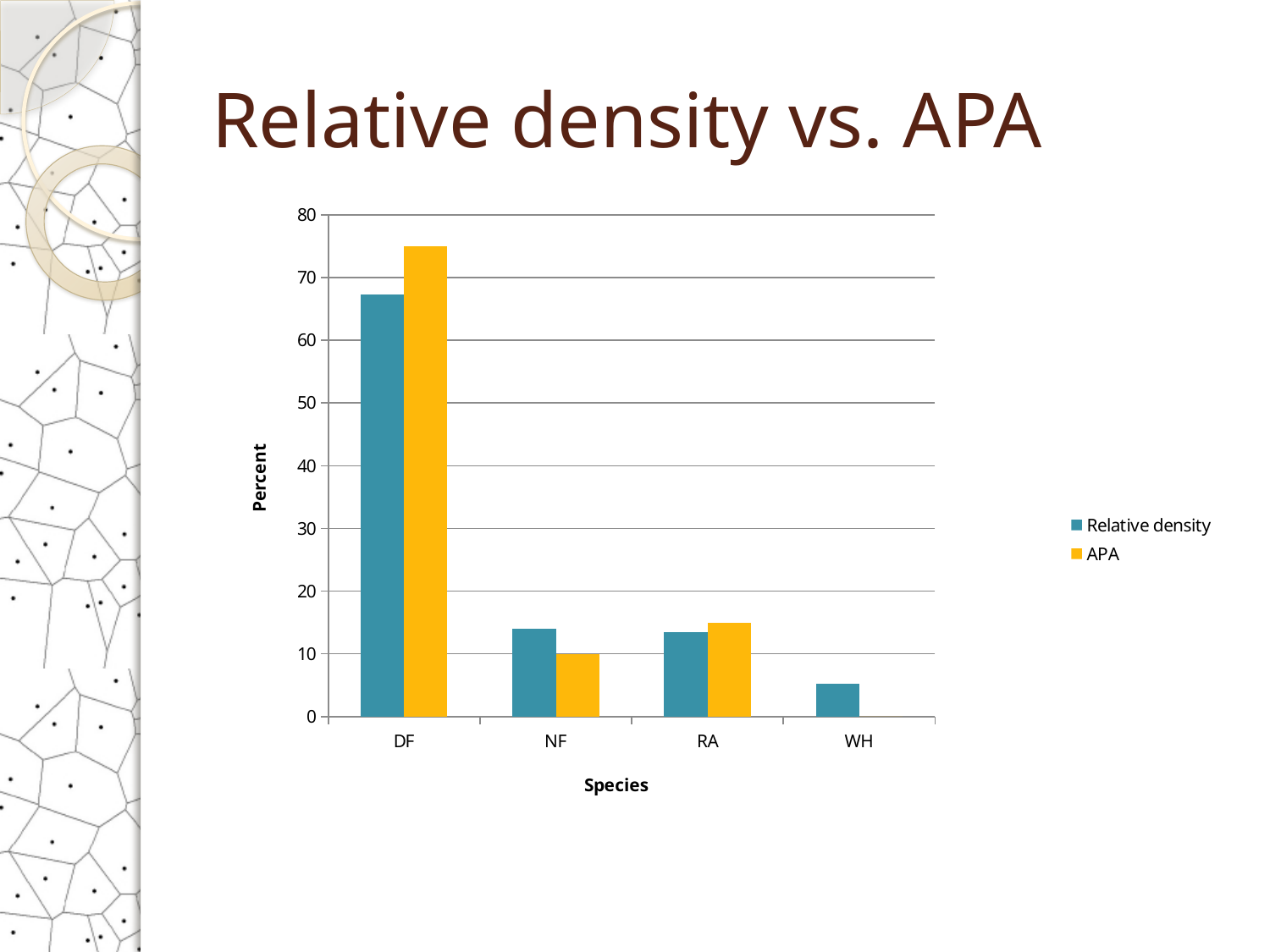
How many species categories are shown on the x axis? 4 Which species has the lowest Relative density? WH Is the Relative density value for WH greater or less than 10? less For DF, which is larger: Relative density or APA? APA How many series does the legend list? 2 Which species has the highest APA value? DF Is the Relative density value for DF greater or less than 60? greater What kind of chart is shown on the slide? bar chart Is the APA value for DF greater or less than 70? greater Which species has the highest Relative density? DF What is the label of the y axis? Percent For NF, which is larger: Relative density or APA? Relative density